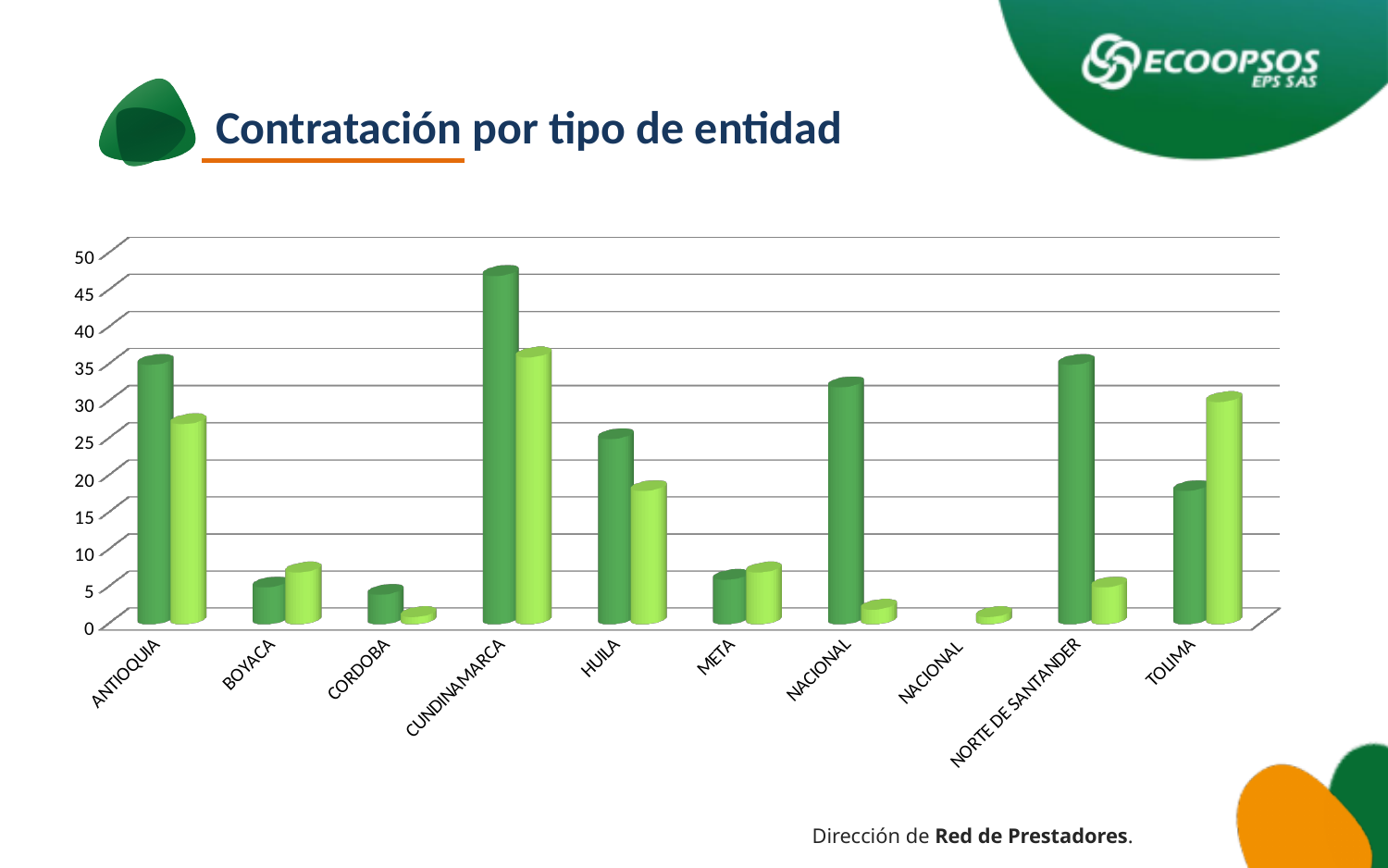
Is the dark green value for CUNDINAMARCA greater or less than 40? greater Which category has the tallest light green bar? CUNDINAMARCA Is the dark green value for HUILA greater or less than 20? greater Is the dark green value for the first NACIONAL category greater or less than 20? greater Which category has the tallest dark green bar? CUNDINAMARCA What is the title of the slide containing the chart? Contratación por tipo de entidad For ANTIOQUIA, which bar is taller, the dark green or the light green? dark green What kind of chart is shown on the slide? bar chart How many categories are shown on the x axis of the chart? 10 For NORTE DE SANTANDER, which bar is taller, the dark green or the light green? dark green For TOLIMA, which bar is taller, the dark green or the light green? light green